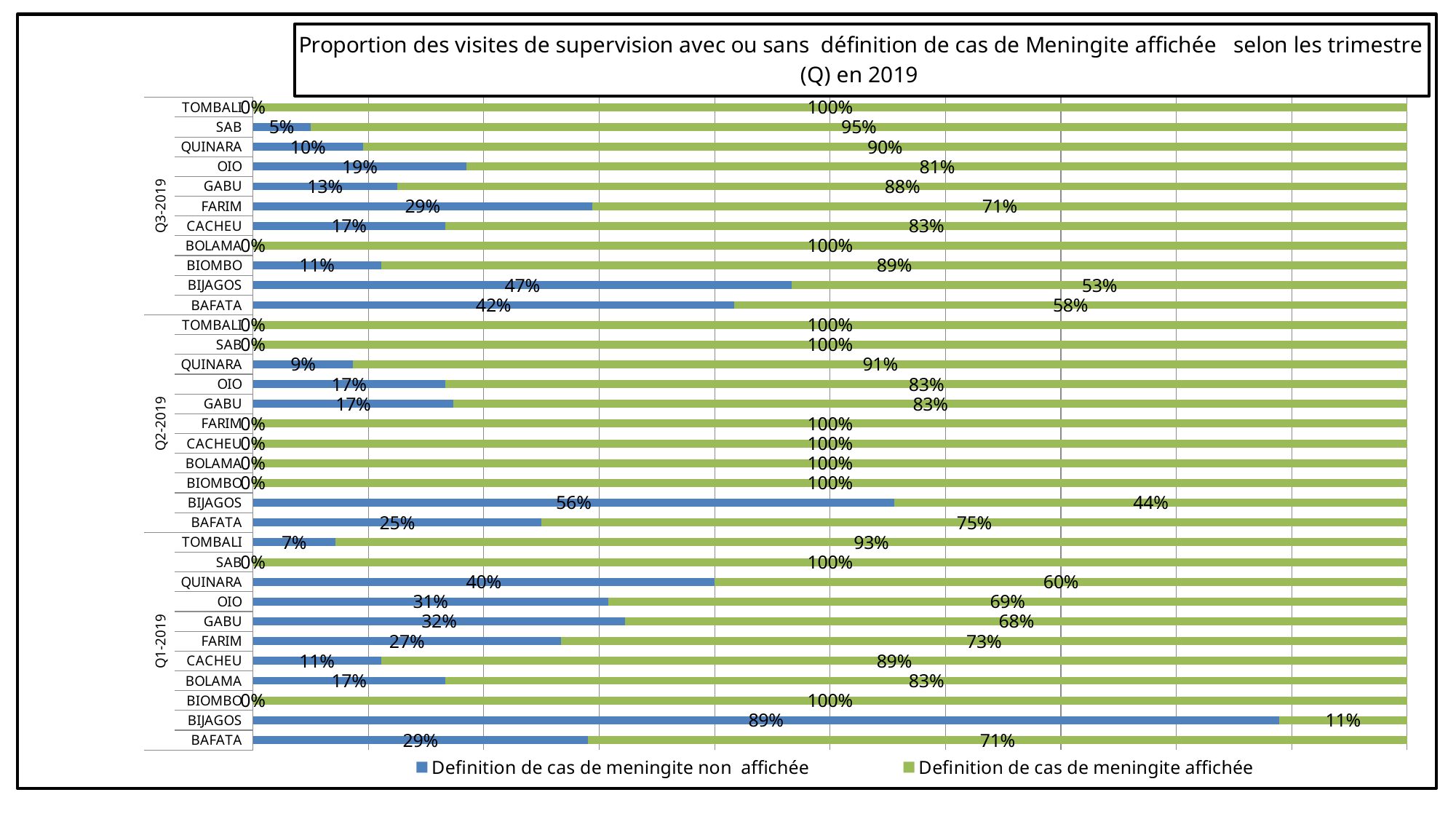
How many series does the legend list? 2 In Q2-2019, what is the difference between the 'non affichée' and 'affichée' values for BIJAGOS? 12 percentage points In Q1-2019, which region has the highest value for 'Definition de cas de meningite non affichée'? BIJAGOS In Q1-2019, what is the value for BIJAGOS in the series 'Definition de cas de meningite affichée'? 11% In Q2-2019, what is the value for QUINARA in the series 'Definition de cas de meningite affichée'? 91% What kind of chart is shown on the slide? bar chart What are the two legend entries of the chart? Definition de cas de meningite non affichée; Definition de cas de meningite affichée How many regions are listed within each quarter group? 11 In Q3-2019, what is the value for BIJAGOS in the series 'Definition de cas de meningite non affichée'? 47% In Q3-2019, which has the larger 'Definition de cas de meningite non affichée' value, FARIM or OIO? FARIM How many quarter groups (Q1-2019, Q2-2019, Q3-2019) are shown on the y axis? 3 In Q3-2019, which region has the lowest value for 'Definition de cas de meningite affichée'? BIJAGOS